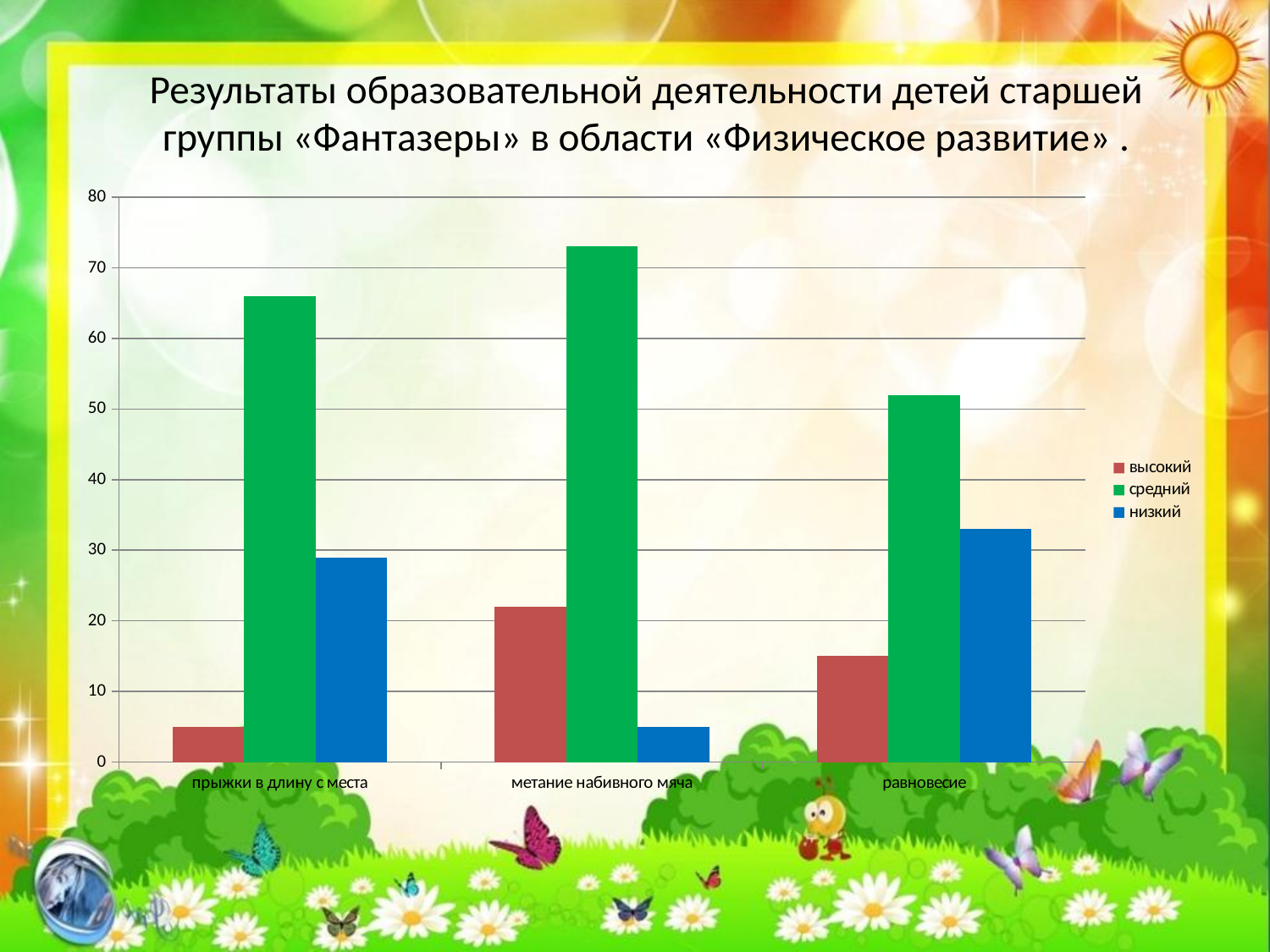
Is the value for "средний" in "равновесие" greater or less than 60? less Is the value for "высокий" in "метание набивного мяча" greater or less than 20? greater Which is larger: the value for "низкий" in "прыжки в длину с места" or the value for "низкий" in "равновесие"? равновесие How many categories are shown on the x axis? 3 Which category has the lowest value for the series "высокий"? прыжки в длину с места How many series does the legend list? 3 Which category has the lowest value for the series "низкий"? метание набивного мяча Which series is shown in blue in the legend? низкий Is the value for "низкий" in "равновесие" greater or less than 30? greater Which category has the highest value for the series "средний"? метание набивного мяча What kind of chart is shown on the slide? bar chart